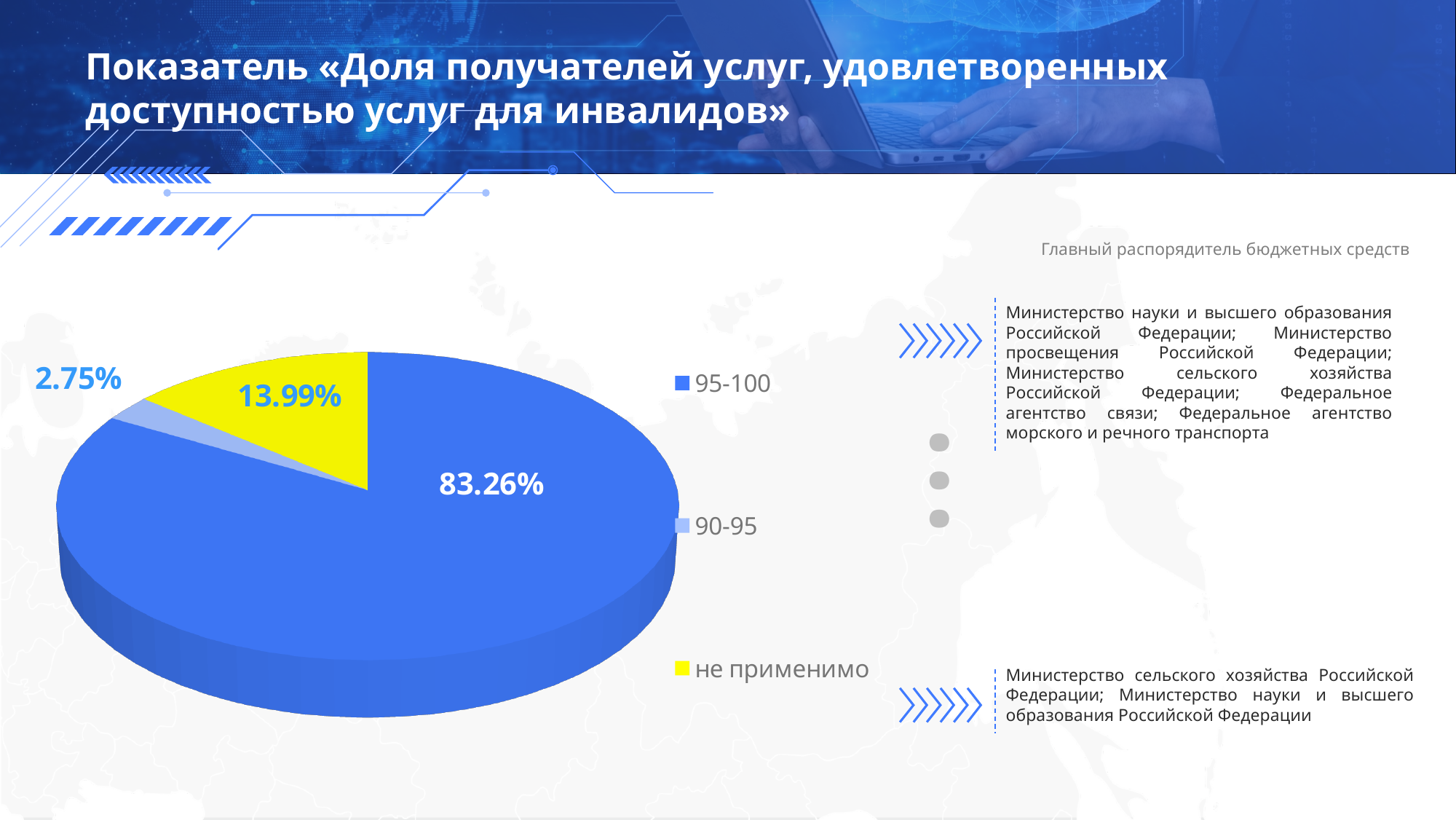
Which category has the largest slice of the pie? 95-100 What kind of chart is shown on the slide? pie chart How many slices does the pie chart have? 3 What is the difference between the "95-100" share and the "не применимо" share? 69.27% What share of the pie does the "90-95" slice represent? 2.75% What colour is the "не применимо" slice in the pie chart? yellow What share of the pie does the "не применимо" slice represent? 13.99% What share of the pie does the "95-100" slice represent? 83.26% Which category has the smallest slice of the pie? 90-95 How many entries does the legend list? 3 What is the difference between the "не применимо" share and the "90-95" share? 11.24% Which is larger, the "не применимо" slice or the "90-95" slice? не применимо